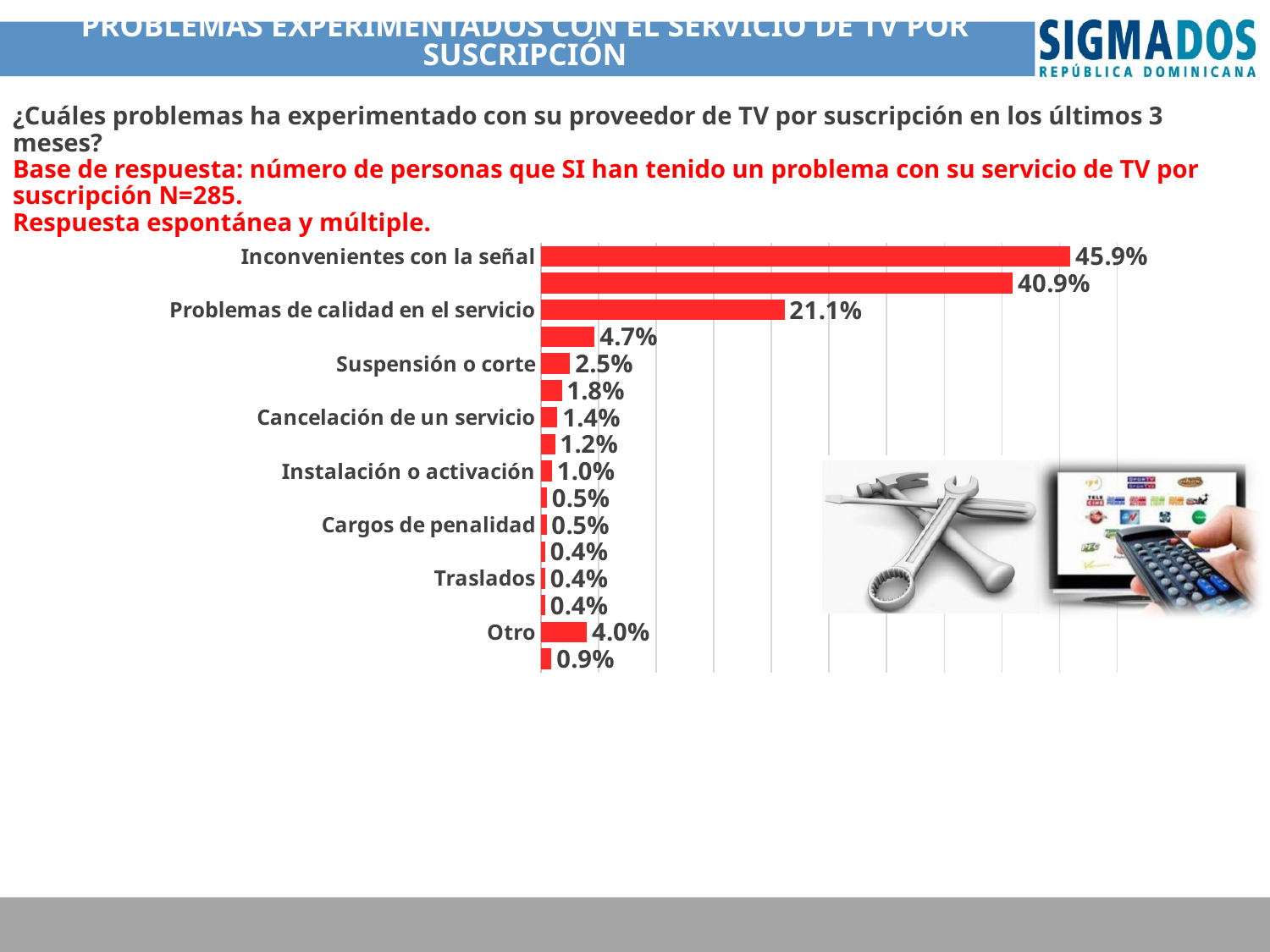
What is the difference between Inconvenientes con la señal and Problemas de calidad en el servicio? 24.8 percentage points What colour are the bars in the chart? Red What is the value for Otro? 4.0% What is the difference between Otro and Suspensión o corte? 1.5 percentage points Which is larger, Cancelación de un servicio or Instalación o activación? Cancelación de un servicio What is the value for Inconvenientes con la señal? 45.9% What is the value for Cargos de penalidad? 0.5% Which labelled category has the highest value? Inconvenientes con la señal What kind of chart is shown on the slide? Bar chart What is the value for Problemas de calidad en el servicio? 21.1% What is the value for Cancelación de un servicio? 1.4% What is the value for Suspensión o corte? 2.5%